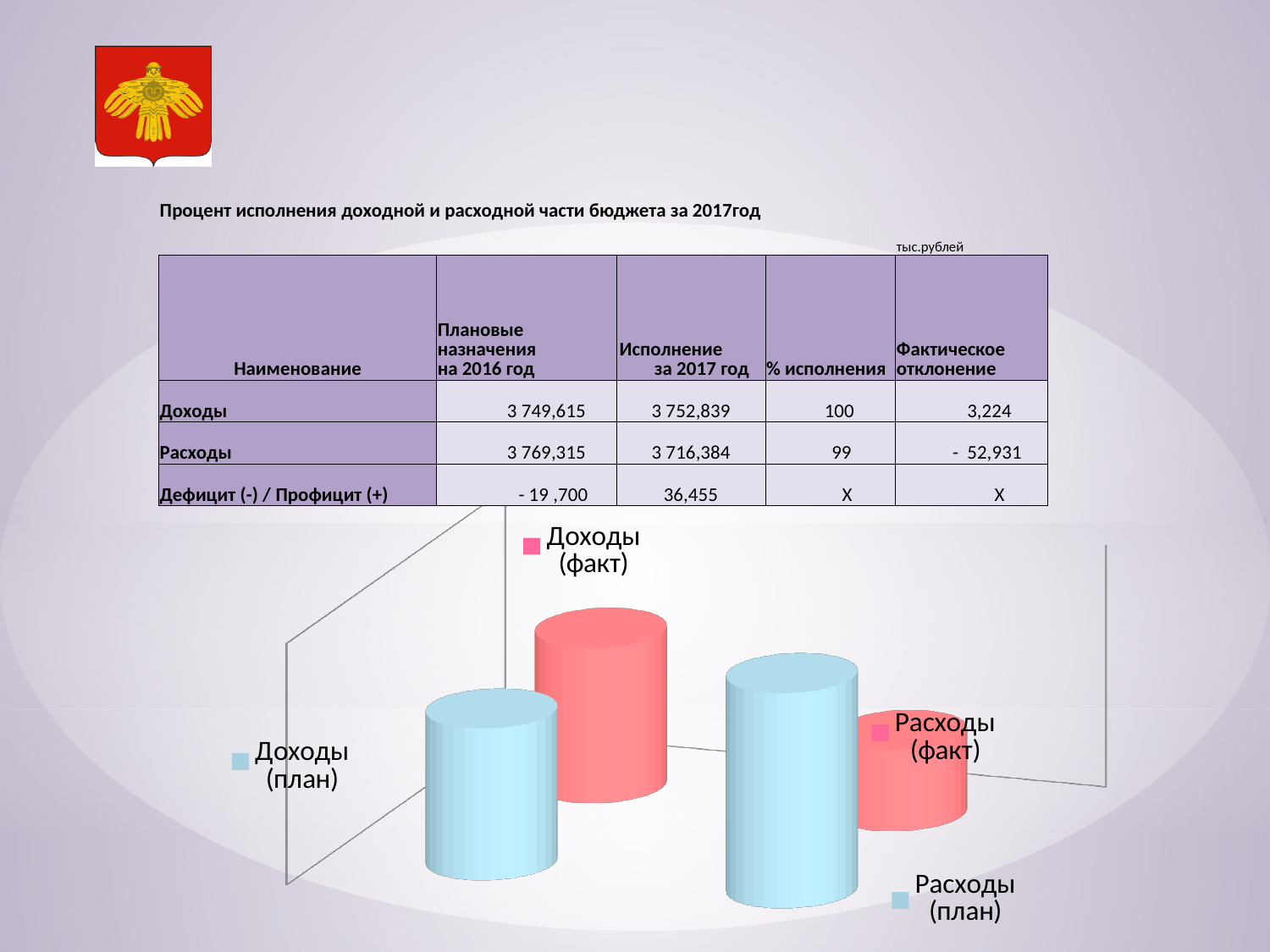
What colour is the Доходы (факт) bar in the chart? pink/red What colour is the Доходы (план) bar in the chart? light blue In the chart, which is taller: Расходы (план) or Расходы (факт)? Расходы (план) How many bars are plotted in the chart? 4 Which bar in the chart is the tallest? Расходы (план) Which bar in the chart is the shortest? Расходы (факт) What kind of chart is shown on the slide? bar chart